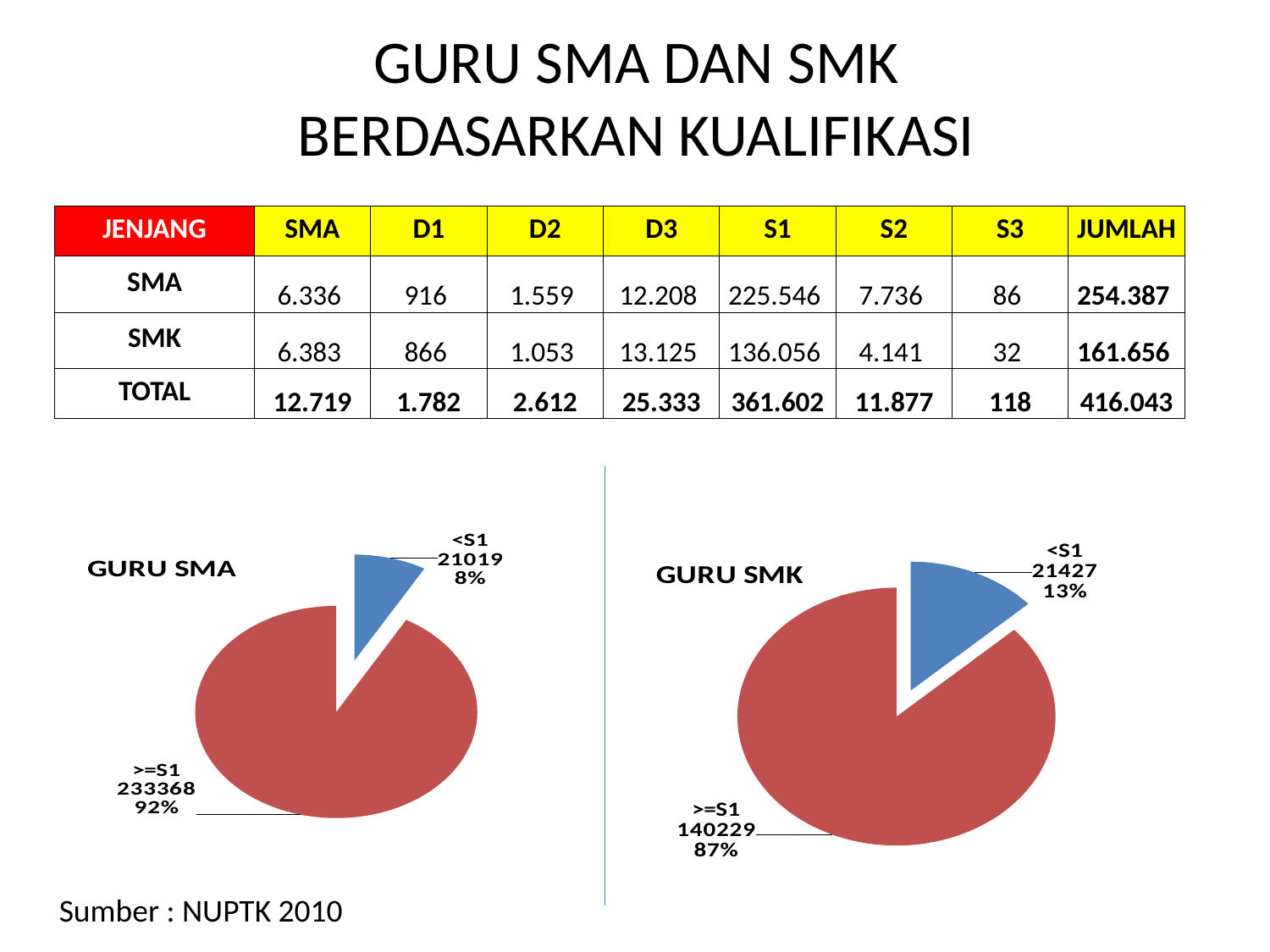
In the GURU SMK chart, which slice is the largest? >=S1 In the GURU SMK chart, what share of the pie does the >=S1 slice represent? 87% What kind of chart is the GURU SMA chart? Pie chart In the GURU SMA chart, what value is shown for the >=S1 slice? 233368 Which is larger: the <S1 value in the GURU SMA chart or the <S1 value in the GURU SMK chart? GURU SMK In the GURU SMA chart, what share of the pie does the <S1 slice represent? 8% In the GURU SMA chart, what is the difference between the >=S1 value and the <S1 value? 212349 In the GURU SMA chart, which slice is the smallest? <S1 In the GURU SMA chart, what value is shown for the <S1 slice? 21019 In the GURU SMK chart, what value is shown for the <S1 slice? 21427 In the GURU SMK chart, what value is shown for the >=S1 slice? 140229 How many slices does the GURU SMK chart have? 2